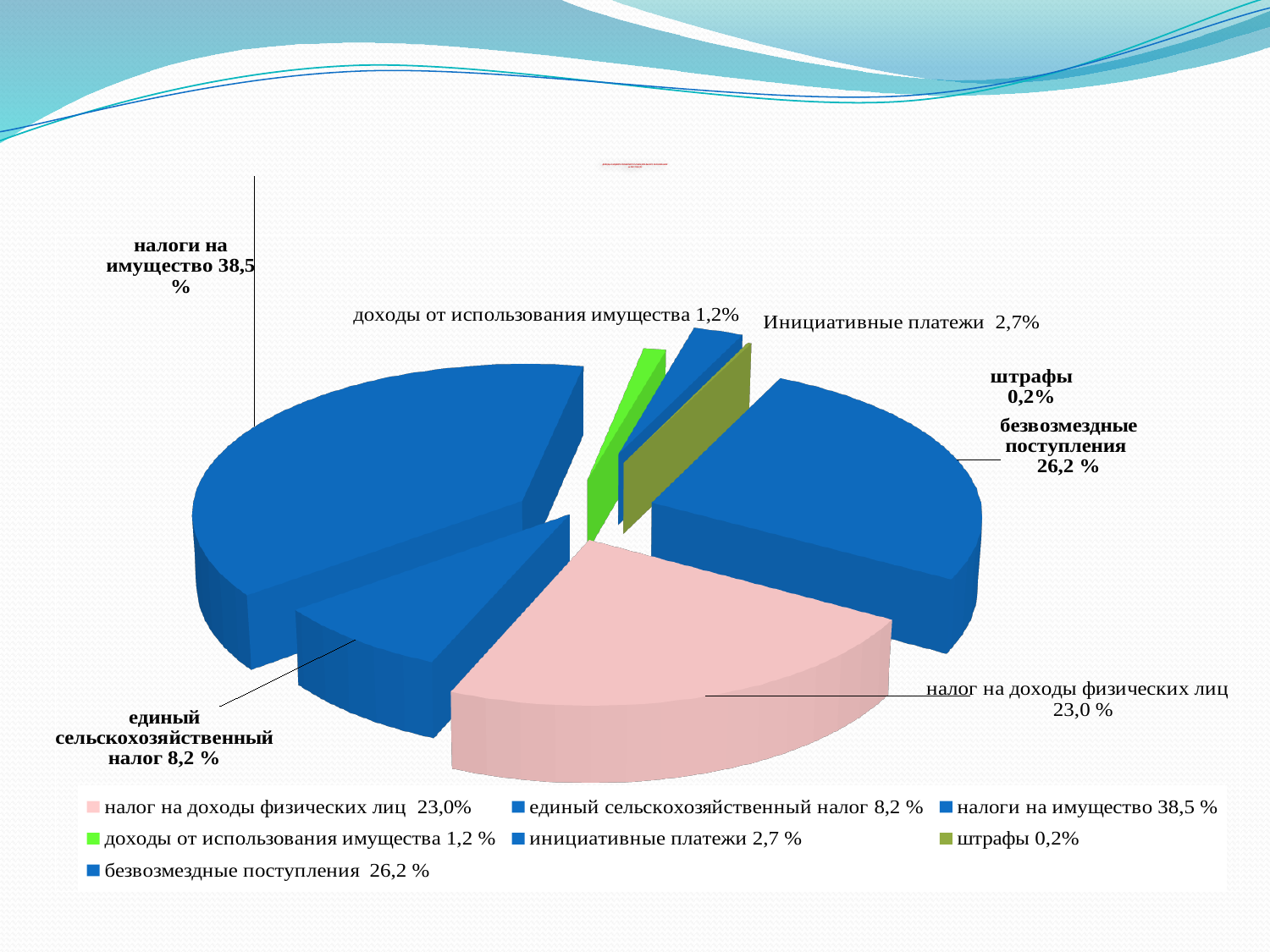
What share of the pie is налог на доходы физических лиц? 23,0 % What is the difference in percentage points between налоги на имущество and безвозмездные поступления? 12,3 What colour is the slice for налог на доходы физических лиц? pink Which is larger: инициативные платежи or доходы от использования имущества? инициативные платежи What share of the pie is безвозмездные поступления? 26,2 % How many slices does the pie chart have? 7 What share of the pie is штрафы? 0,2% Which category has the smallest slice of the pie? штрафы What kind of chart is shown on the slide? pie chart What share of the pie is налоги на имущество? 38,5 % What share of the pie is единый сельскохозяйственный налог? 8,2 % Which category has the largest slice of the pie? налоги на имущество